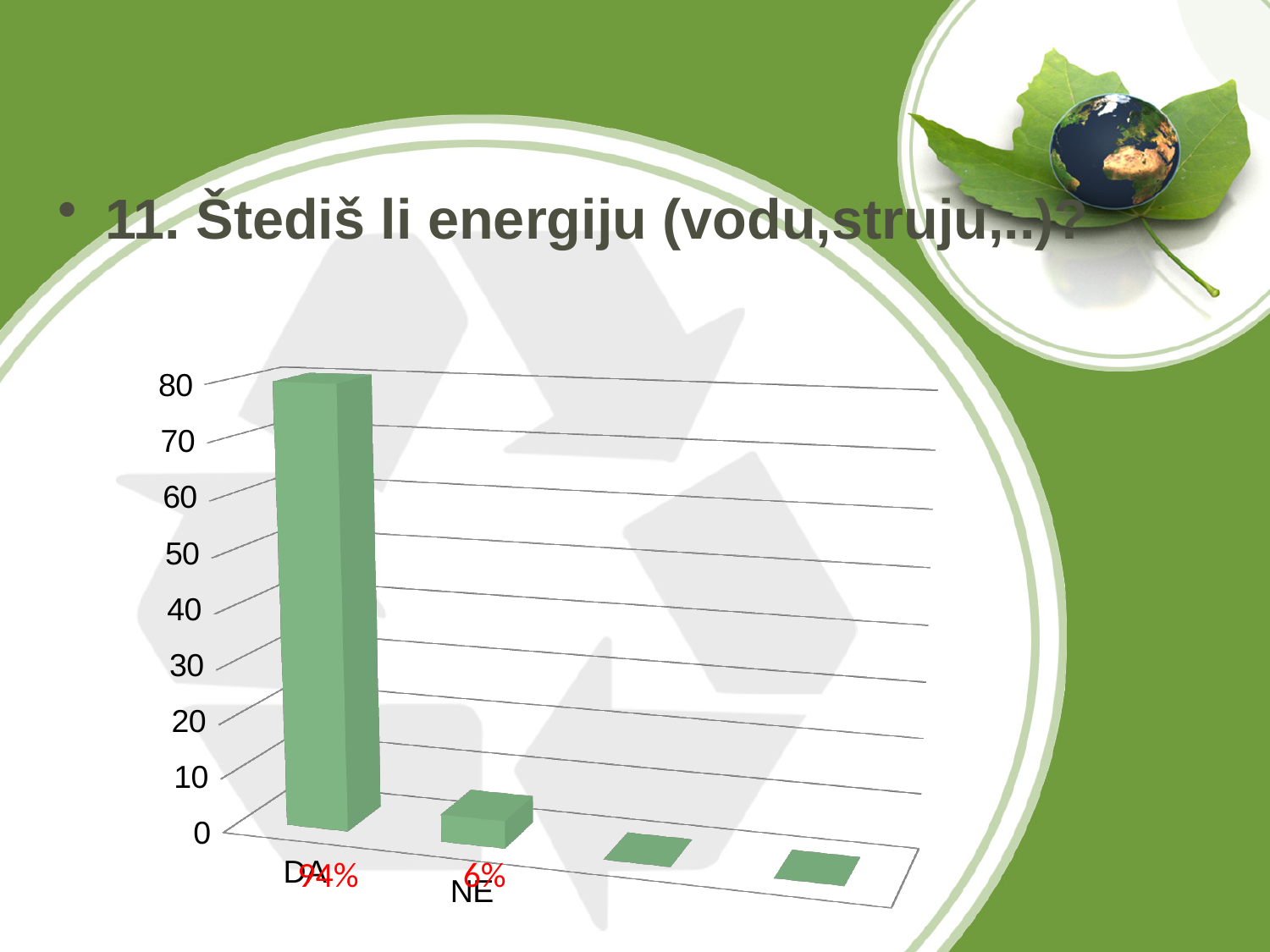
Is the bar for DA greater or less than 40 on the axis? greater Do the bars rise or fall going from DA to NE along the x axis? fall Is the bar for NE greater or less than 10 on the axis? less What is the difference between the percentages shown for DA and NE? 88% What kind of chart is shown on the slide? bar chart Which category has the highest bar? DA Which is larger, the value for DA or the value for NE? DA What percentage is shown for the NE category? 6% Which category has the lowest bar among the labelled categories? NE What percentage is shown for the DA category? 94% What is the question shown as the title above the chart? 11. Štediš li energiju (vodu,struju,..)? What is the highest value shown on the vertical axis? 80